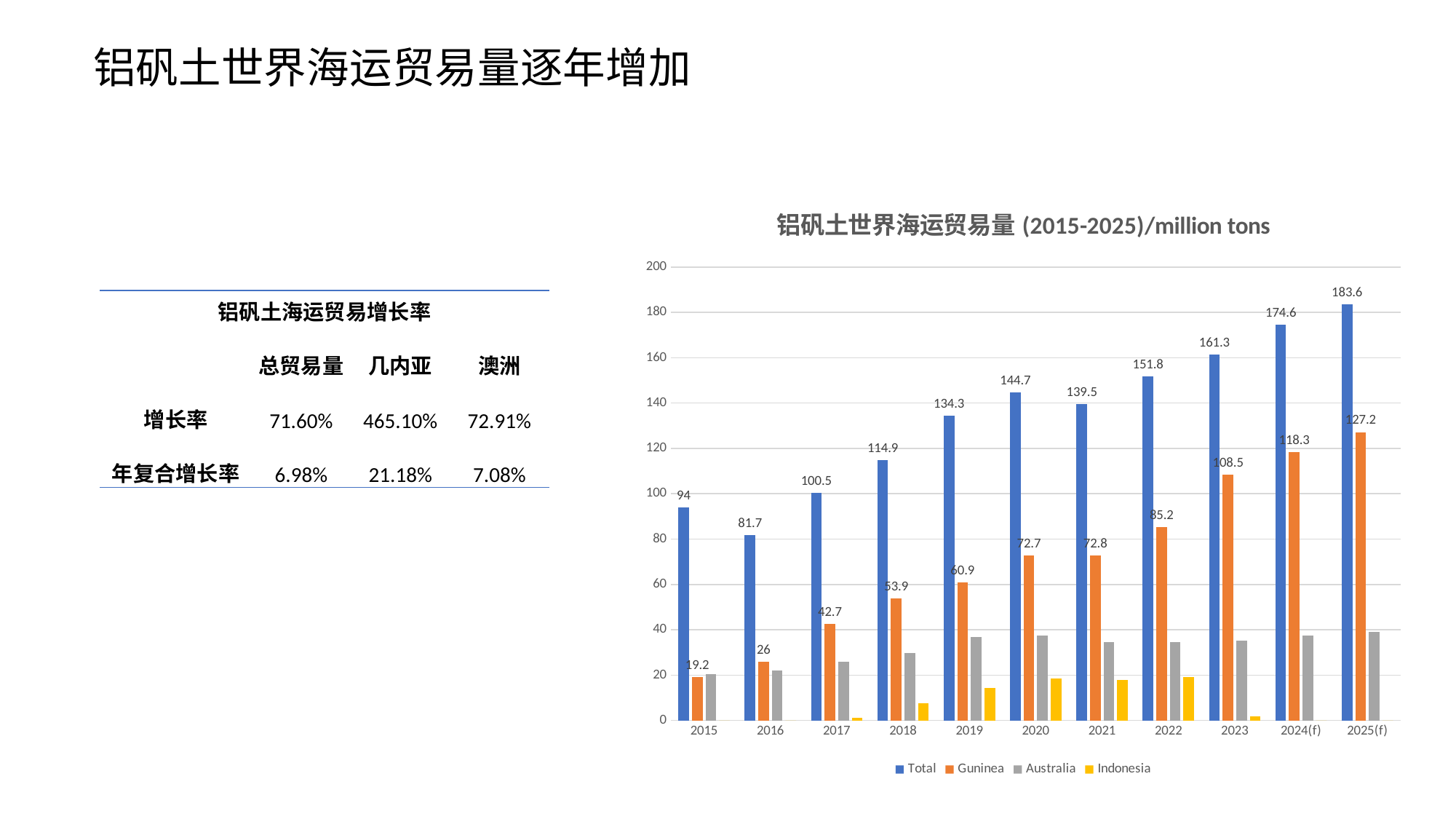
What is the Guinea value for 2023? 108.5 Which year has the lowest Total value? 2016 What is the Total value for 2019? 134.3 Is the Australia value for 2020 greater or less than 40? less Which is larger, the Guinea value for 2022 or the Total value for 2016? Guinea value for 2022 How many series does the legend list? 4 How many years are shown on the x axis? 11 What is the Total value for 2025(f)? 183.6 What is the difference between the Total values for 2024(f) and 2023? 13.3 Which year has the highest Guinea value? 2025(f) Is the Indonesia value for 2017 greater or less than 20? less What kind of chart is shown on the slide? bar chart